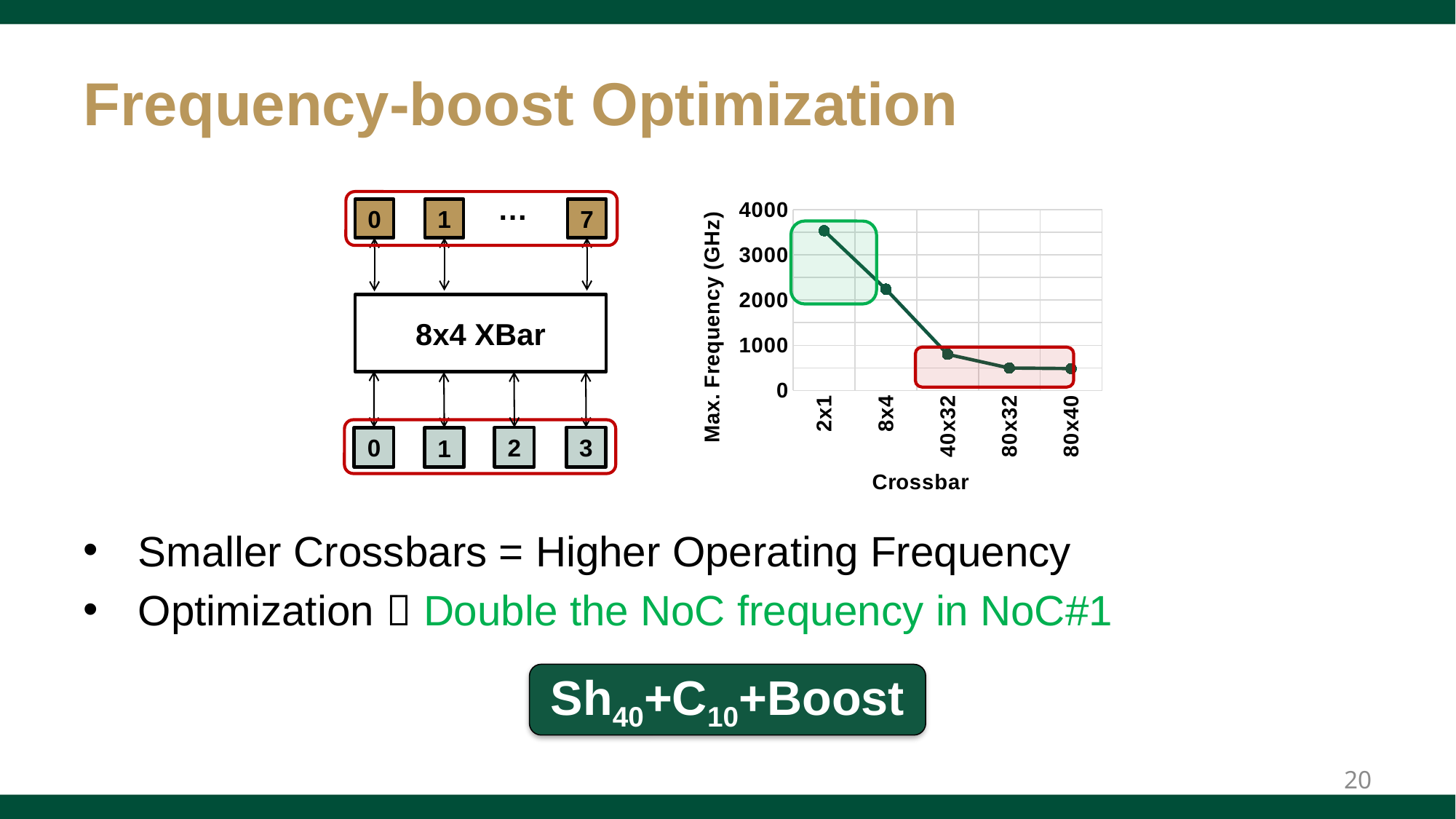
What is the label of the y axis of the chart? Max. Frequency (GHz) Is the maximum frequency for the 2x1 crossbar greater or less than 3000? greater What kind of chart is shown on the slide? line chart Which has a higher maximum frequency, the 2x1 crossbar or the 8x4 crossbar? 2x1 Which has a higher maximum frequency, the 8x4 crossbar or the 40x32 crossbar? 8x4 Is the maximum frequency for the 40x32 crossbar greater or less than 1000? less Is the maximum frequency for the 80x40 crossbar greater or less than 1000? less Do the values in the chart rise or fall as you move from 2x1 to 80x40 along the x axis? fall Which crossbar has the highest maximum frequency in the chart? 2x1 What is the label of the x axis of the chart? Crossbar How many crossbar categories are plotted on the x axis of the chart? 5